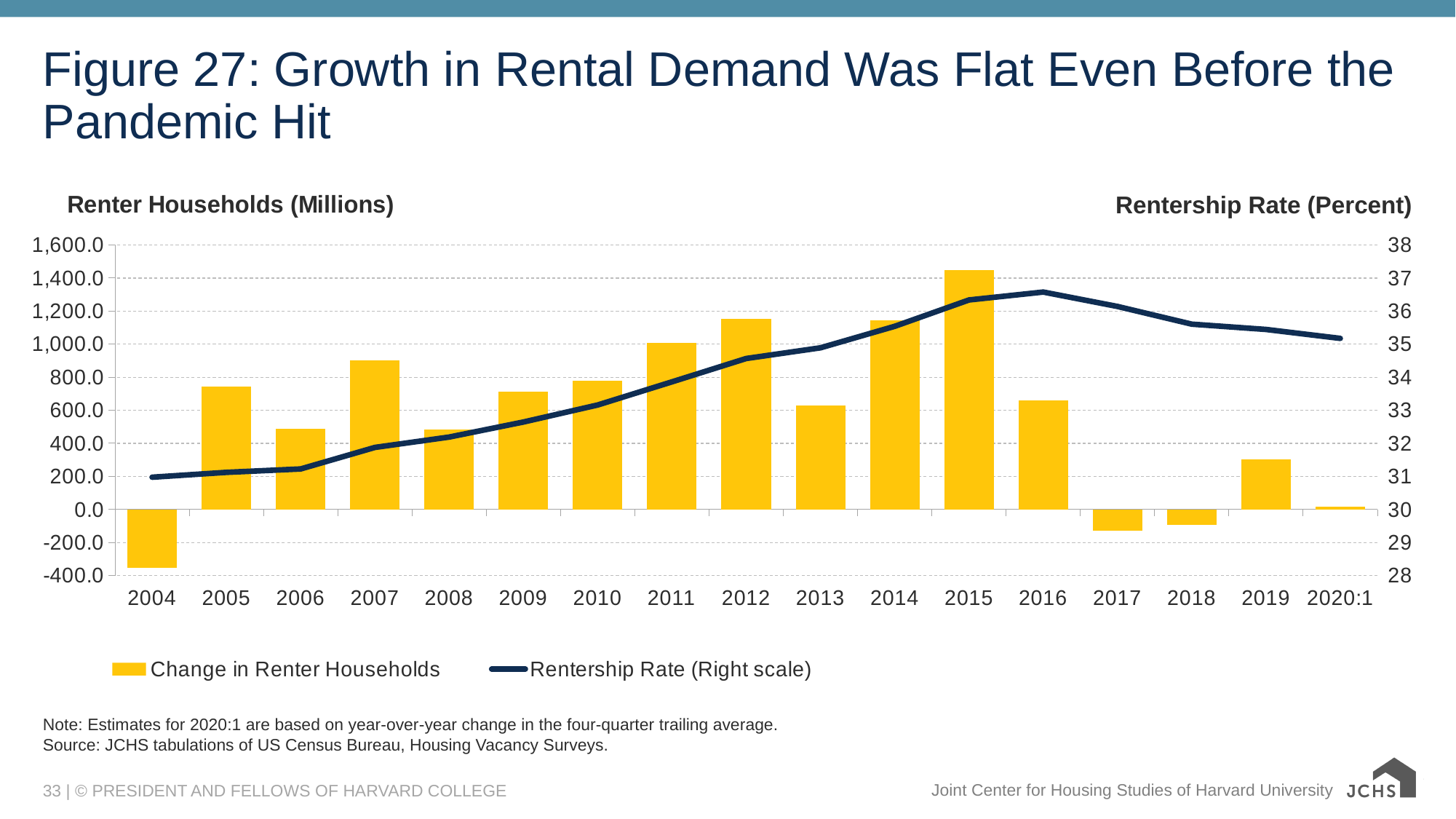
Which year has the highest Change in Renter Households? 2015 How many series does the legend list? 2 Which year has the larger Change in Renter Households, 2012 or 2013? 2012 What is the label of the right-hand axis? Rentership Rate (Percent) Is the Change in Renter Households for 2019 greater or less than 400.0? less Which year has the lowest Change in Renter Households? 2004 How many years (categories) are shown on the x axis? 17 Is the Change in Renter Households for 2004 greater or less than -200.0? less Is the Change in Renter Households for 2015 greater or less than 1,200.0? greater Does the Rentership Rate rise or fall from 2004 to 2016? rise What kind of chart is shown on the slide? A combined bar and line chart